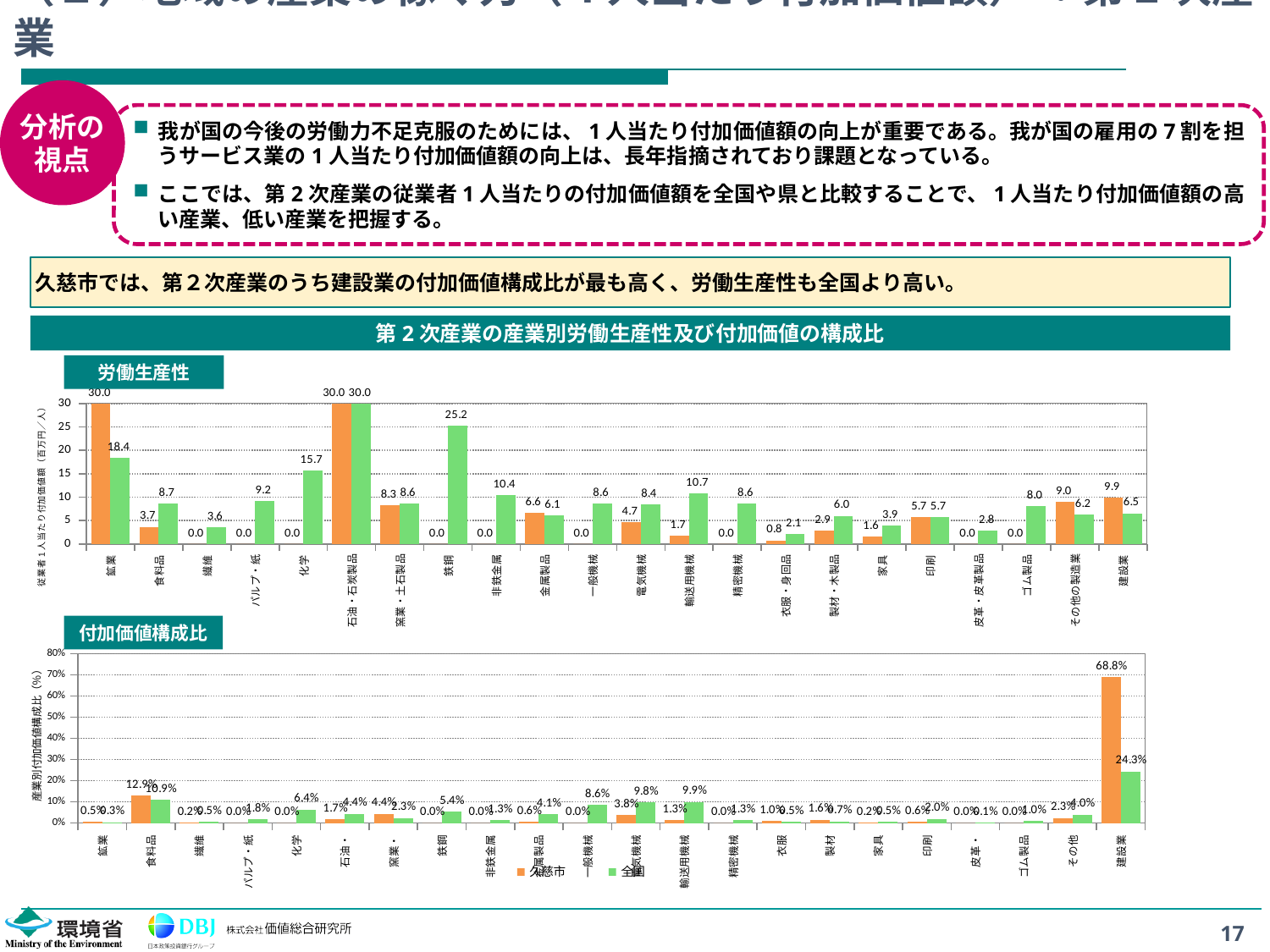
In the 付加価値構成比 chart, what is the value for 久慈市 in 建設業? 68.8% In the 付加価値構成比 chart, is the value for 久慈市 in 建設業 greater or less than 60%? greater In the 労働生産性 chart, what is the value for 全国 in 鉄鋼? 25.2 In the 労働生産性 chart, which is larger in 金属製品, 久慈市 or 全国? 久慈市 In the 付加価値構成比 chart, what is the difference between 久慈市 and 全国 in 食料品? 2.0% In the 労働生産性 chart, what is the value for 久慈市 in 建設業? 9.9 In the 労働生産性 chart, what is the difference between 全国 and 久慈市 in 輸送用機械? 9.0 In the 付加価値構成比 chart, which category has the highest 全国 value? 建設業 What kind of chart is the 労働生産性 chart? bar chart How many series does the legend of the 付加価値構成比 chart list? 2 In the 付加価値構成比 chart, what is the value for 全国 in 電気機械? 9.8% In the 労働生産性 chart, which category has the highest 全国 value? 石油・石炭製品